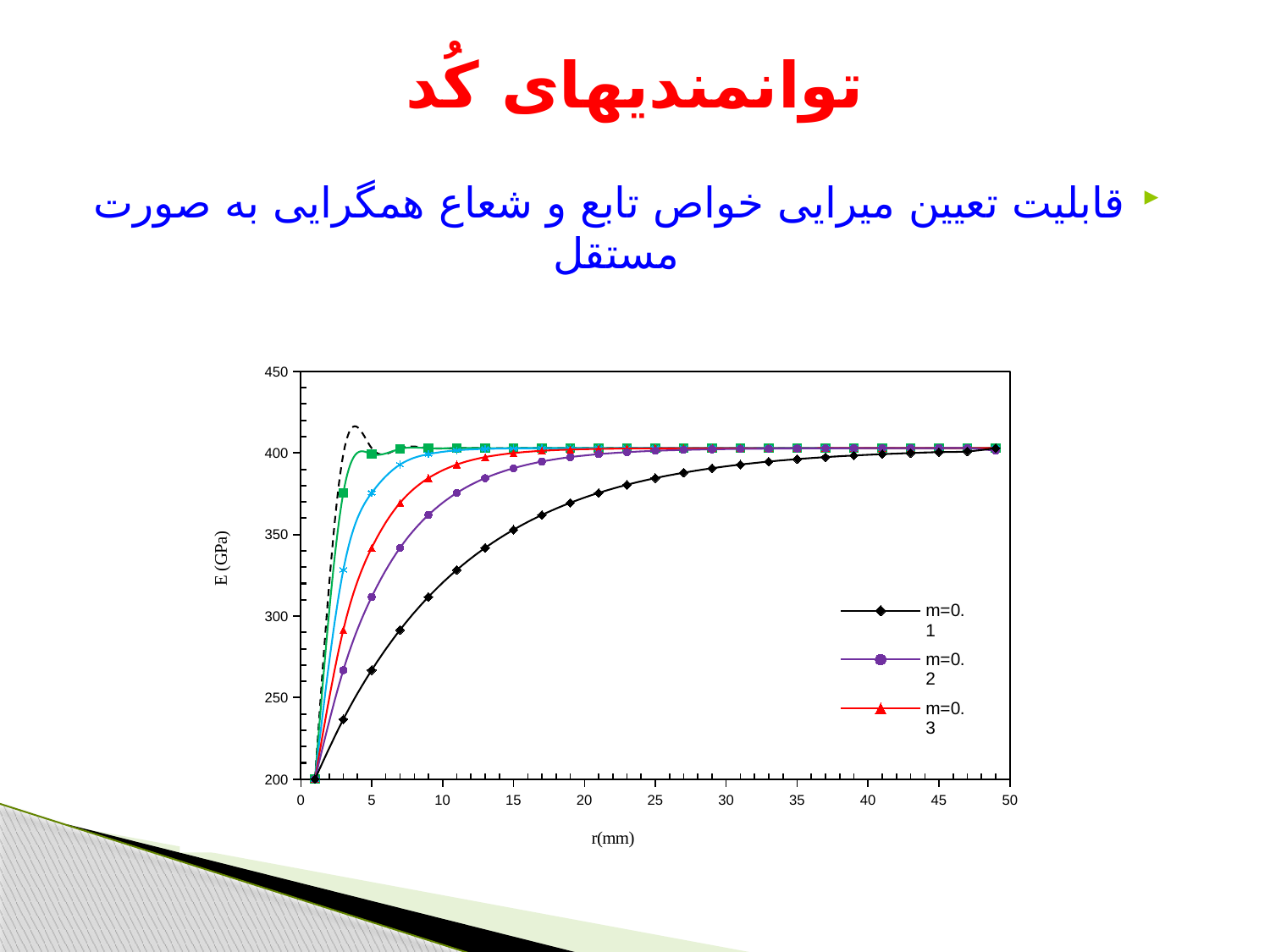
Which of the legend series has the lowest value at r=15? m=0.1 Is the value of the m=0.3 series at r=10 greater or less than 350? greater Is the value of the m=0.2 series at r=5 greater or less than 350? less At r=10, which series has the larger value, m=0.1 or m=0.3? m=0.3 What kind of chart is shown on the slide? line chart What is the label of the y axis? E (GPa) Is the value of the m=0.1 series at r=10 greater or less than 350? less Do the values of the m=0.1 series rise or fall as r increases? rise What is the label of the x axis? r(mm) How many series does the legend list? 3 At r=20, which series has the larger value, m=0.2 or m=0.1? m=0.2